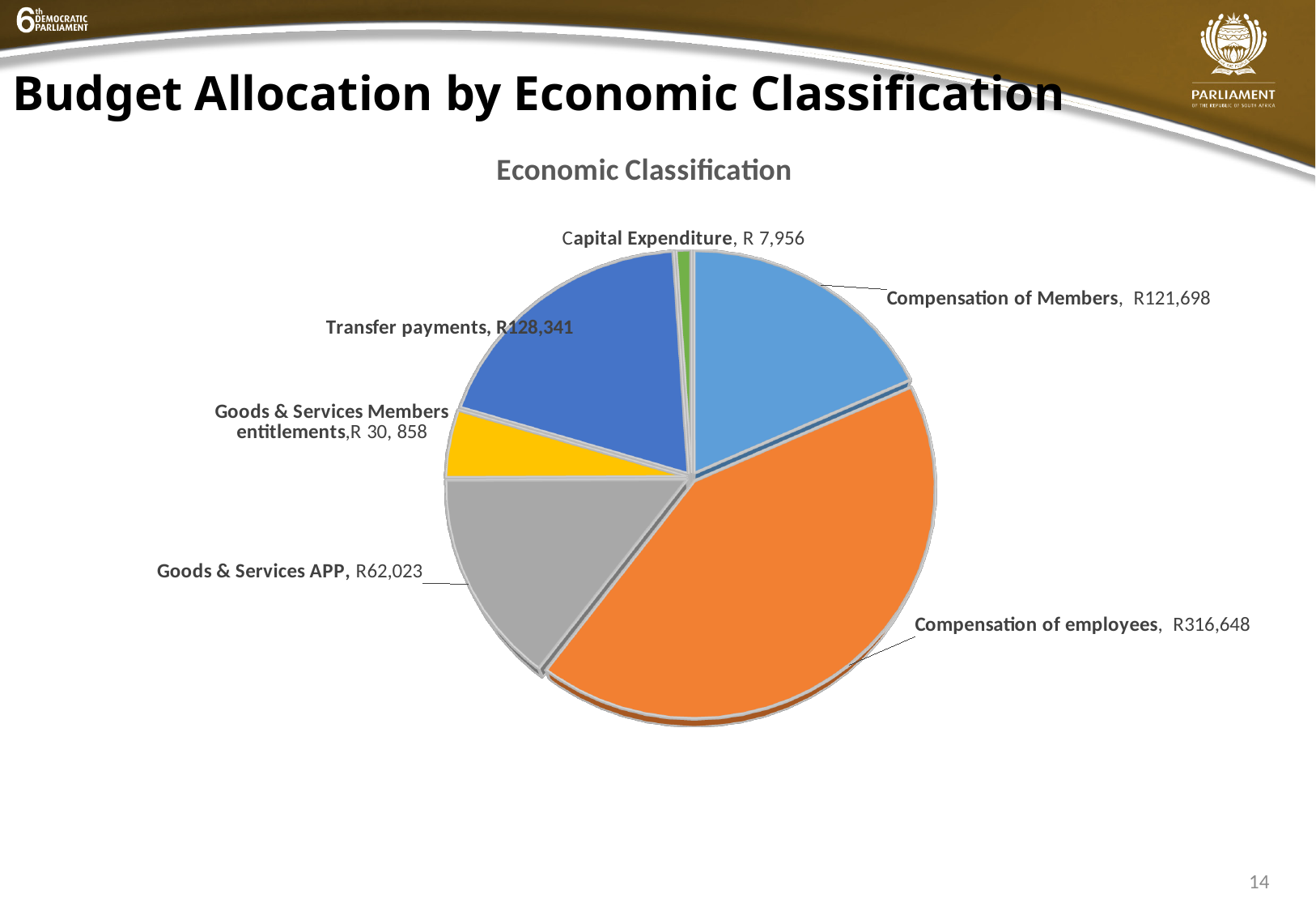
Which category has the smallest slice of the pie? Capital Expenditure Which category has the largest slice of the pie? Compensation of employees What is the title of the chart? Economic Classification What is the value for Compensation of Members? R121,698 What is the value for Capital Expenditure? R 7,956 What type of chart is shown on the slide? pie chart Which is larger, Transfer payments or Compensation of Members? Transfer payments What is the value for Compensation of employees? R316,648 What is the value for Goods & Services APP? R62,023 What is the difference between Compensation of employees and Compensation of Members? R194,950 What is the value for Transfer payments? R128,341 How many slices does the pie chart have? 6